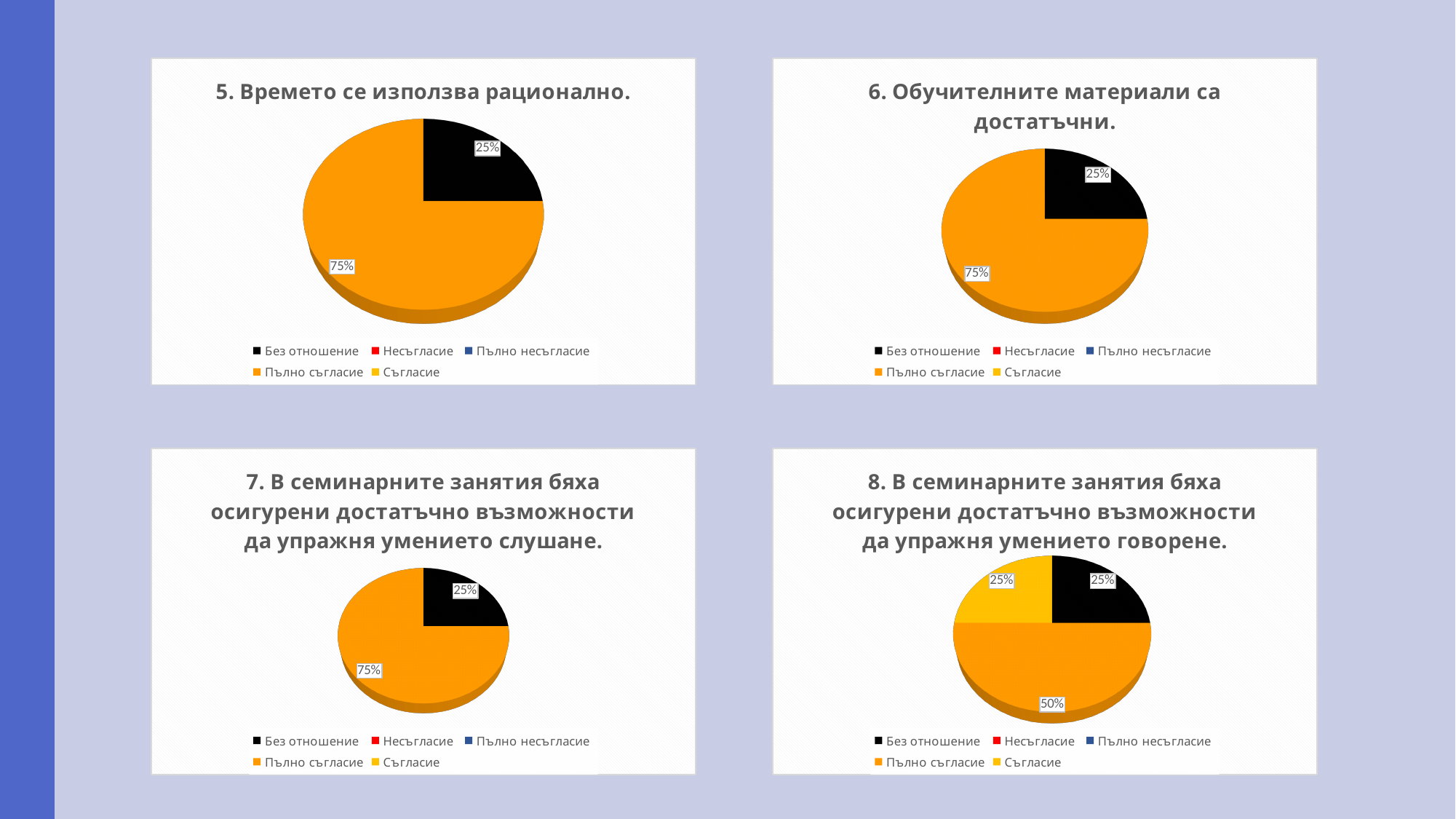
In the chart "6. Обучителните материали са достатъчни.", which category has the largest slice? Пълно съгласие In the chart "7. В семинарните занятия бяха осигурени достатъчно възможности да упражня умението слушане.", which is larger, "Пълно съгласие" or "Без отношение"? Пълно съгласие How many entries does the legend of the chart "5. Времето се използва рационално." list? 5 What kind of chart is used for "5. Времето се използва рационално."? pie chart In the chart "7. В семинарните занятия бяха осигурени достатъчно възможности да упражня умението слушане.", what is the difference between the "Пълно съгласие" and "Без отношение" shares? 50% In the chart "6. Обучителните материали са достатъчни.", what share does "Без отношение" have? 25% In the chart "8. В семинарните занятия бяха осигурени достатъчно възможности да упражня умението говорене.", what share does "Пълно съгласие" have? 50% In the chart "5. Времето се използва рационално.", what share does "Пълно съгласие" have? 75% In the chart "8. В семинарните занятия бяха осигурени достатъчно възможности да упражня умението говорене.", how many slices are shown in the pie? 3 In the chart "8. В семинарните занятия бяха осигурени достатъчно възможности да упражня умението говорене.", what colour is the "Съгласие" slice? yellow